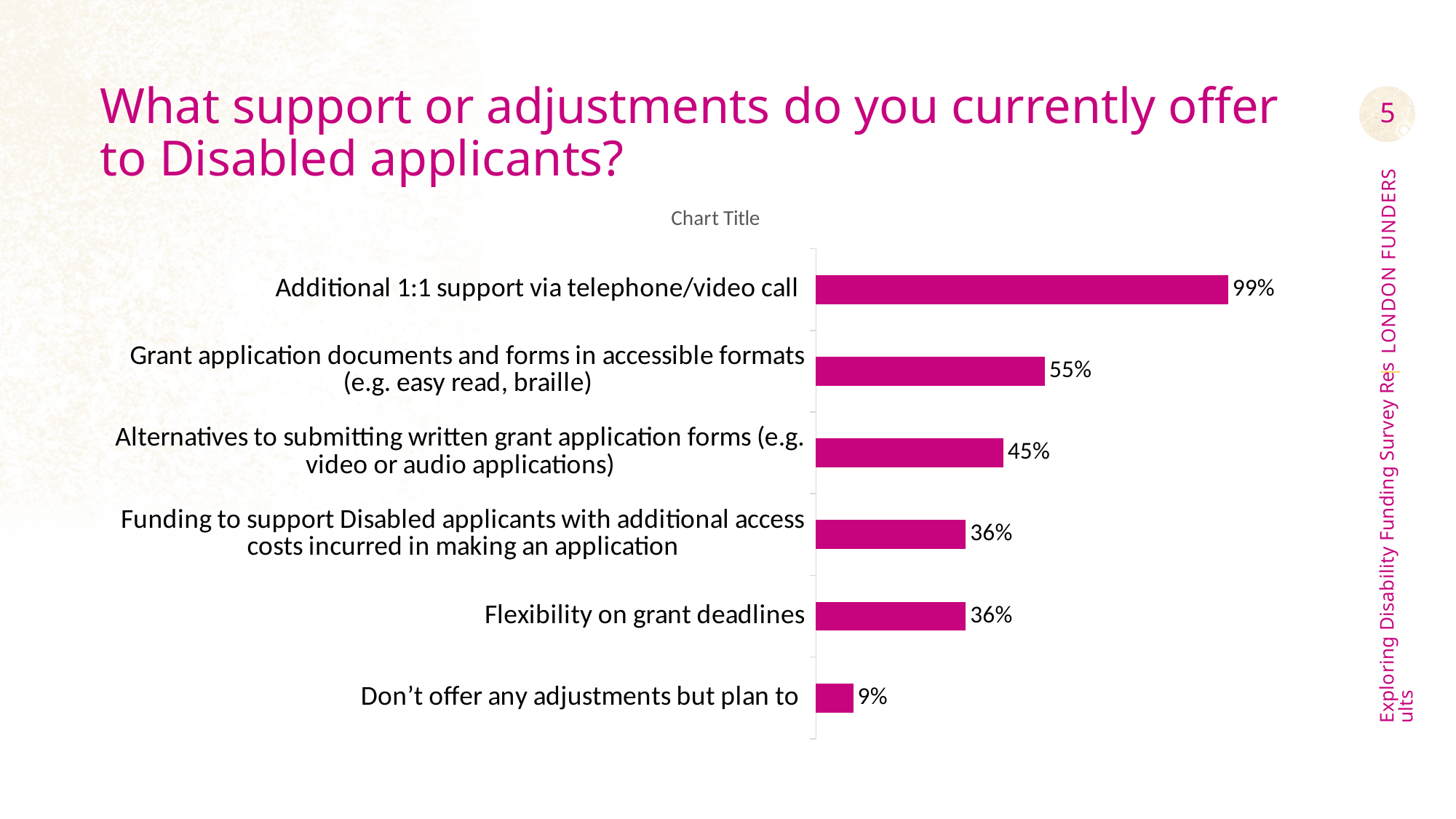
What is the value for 'Grant application documents and forms in accessible formats (e.g. easy read, braille)'? 55% What is the value for 'Alternatives to submitting written grant application forms (e.g. video or audio applications)'? 45% What percentage of respondents offer additional 1:1 support via telephone/video call? 99% What percentage of respondents offer flexibility on grant deadlines? 36% Which category has the lowest value? Don't offer any adjustments but plan to What is the title shown above the chart? Chart Title What kind of chart is shown on the slide? Bar chart How many categories are shown in the chart? 6 What is the value for 'Don't offer any adjustments but plan to'? 9% What is the difference between the value for additional 1:1 support via telephone/video call and the value for flexibility on grant deadlines? 63% Which category has the highest value? Additional 1:1 support via telephone/video call Which is larger: the value for grant application documents in accessible formats or the value for alternatives to submitting written grant application forms? Grant application documents and forms in accessible formats (e.g. easy read, braille)